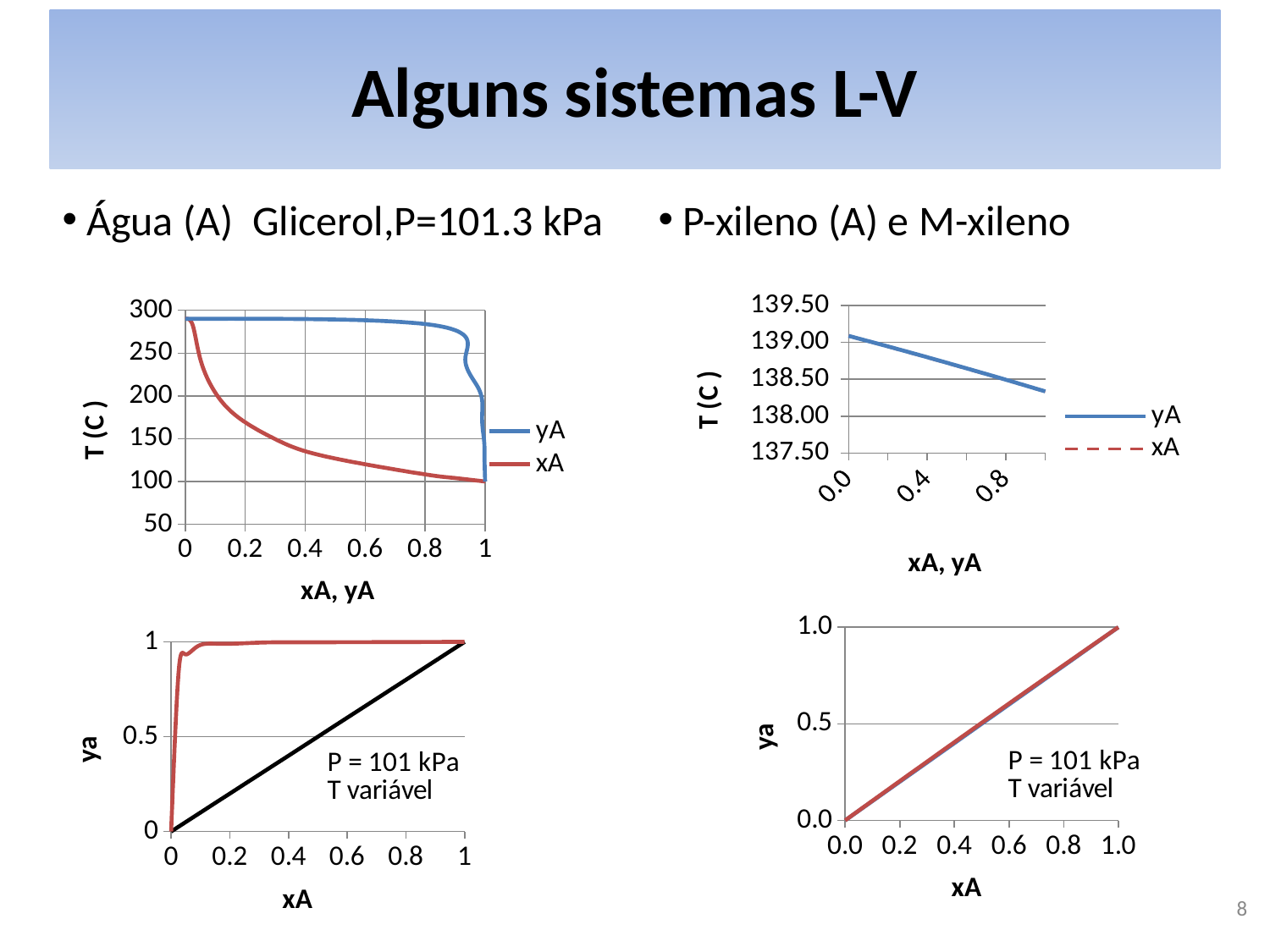
In the top-left chart (T (C) vs xA, yA), what is the highest value shown on the vertical axis? 300 In the top-left chart (T (C) vs xA, yA), what are the two legend entries? yA and xA In the top-left chart (T (C) vs xA, yA), is the value of the yA curve at 0.4 greater or less than 250? greater In the top-right chart (T (C) vs xA, yA), does the yA line rise or fall as xA, yA increases? fall In the top-left chart (T (C) vs xA, yA), is the value of the xA curve at xA = 0.4 greater or less than 150? less In the top-right chart (T (C) vs xA, yA), is the value of the yA line at 0.4 greater or less than 138.50? greater In the bottom-right chart (ya vs xA), what is the value of ya at xA = 1.0? 1.0 How many charts are shown on the slide? 4 In the top-left chart (T (C) vs xA, yA), how many series does the legend list? 2 In the top-left chart (T (C) vs xA, yA), does the xA curve rise or fall as xA increases? fall In the bottom-right chart (ya vs xA), does ya rise or fall as xA increases? rise